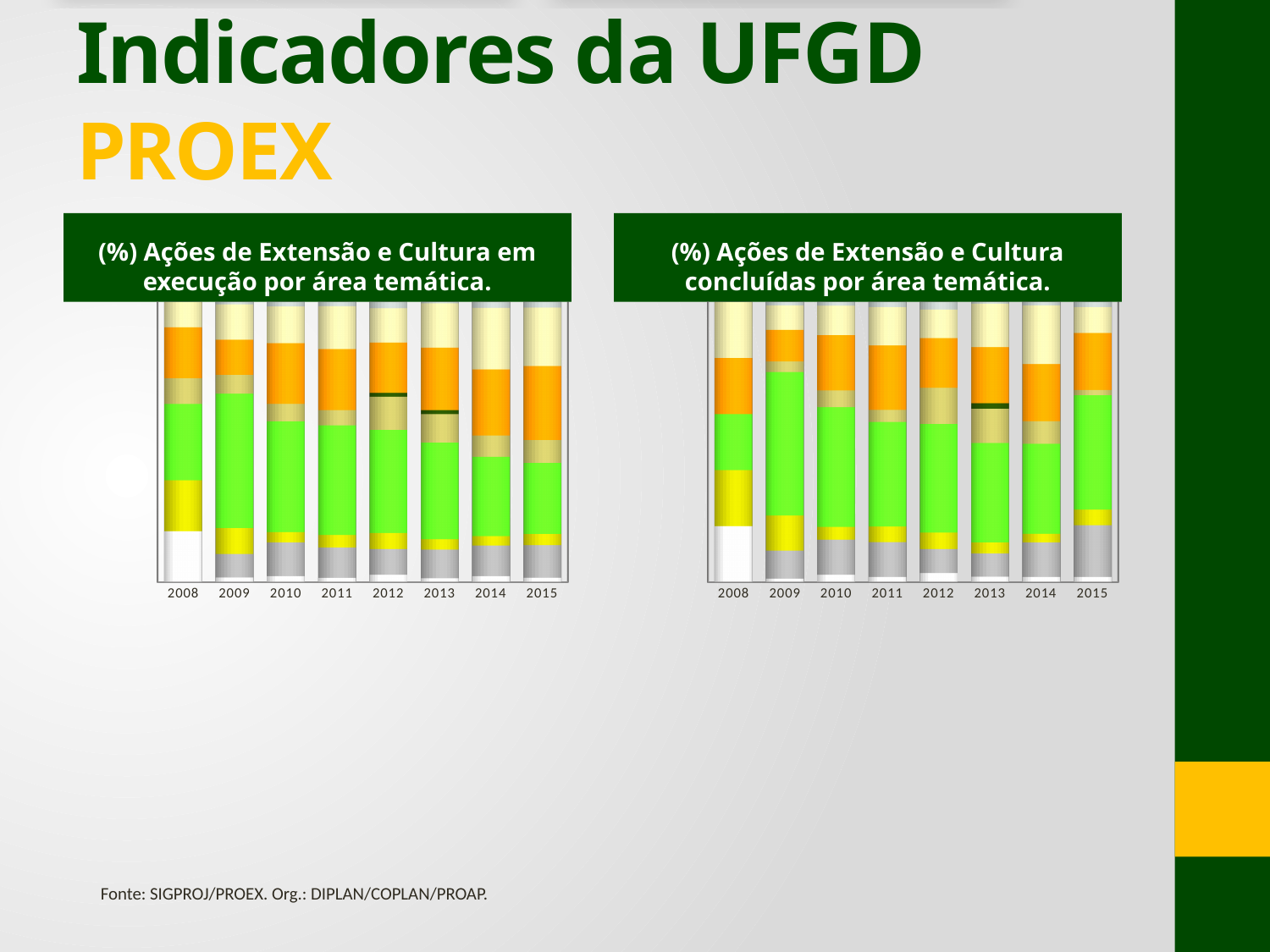
What kind of chart is the left chart, '(%) Ações de Extensão e Cultura em execução por área temática'? Stacked bar chart Do the left and right charts cover the same range of years on their x axes? Yes, 2008 to 2015 What is the title of the chart on the left of the slide? (%) Ações de Extensão e Cultura em execução por área temática. How many years are shown on the x axis of the right chart? 8 What is the title of the chart on the right of the slide? (%) Ações de Extensão e Cultura concluídas por área temática. In the right chart, what is the last year shown on the x axis? 2015 How many years are shown on the x axis of the left chart? 8 What kind of chart is the right chart, '(%) Ações de Extensão e Cultura concluídas por área temática'? Stacked bar chart In the left chart, what is the first year shown on the x axis? 2008